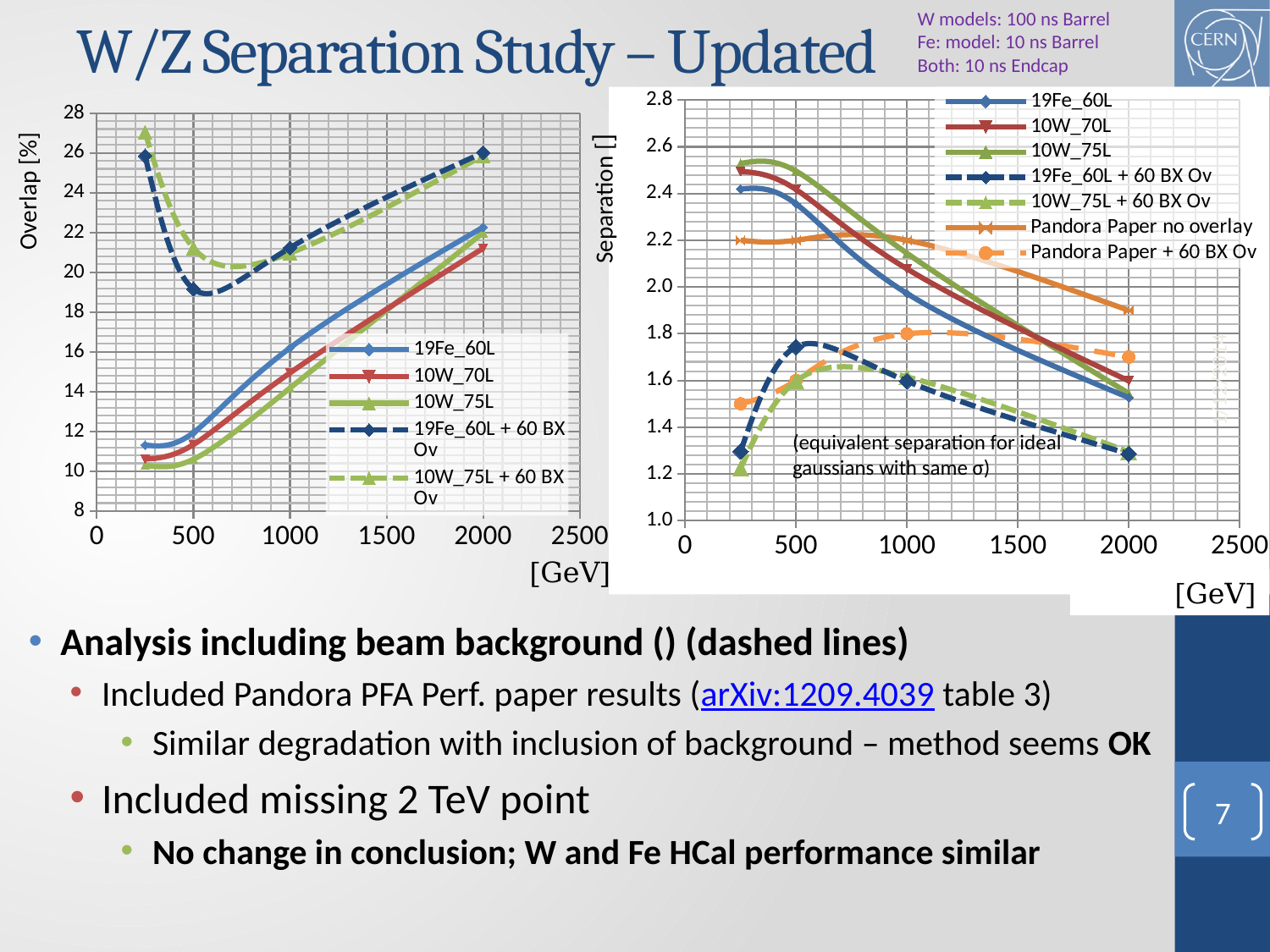
In the right chart (Separation []), which is larger at 2000 GeV: Pandora Paper no overlay or 19Fe_60L? Pandora Paper no overlay In the left chart (Overlap [%]), is the value for 19Fe_60L at 2000 GeV greater or less than 20? greater In the right chart (Separation []), do the solid-line series 19Fe_60L, 10W_70L and 10W_75L rise or fall as energy increases from 500 to 2000 GeV? fall In the right chart (Separation []), is the value for 19Fe_60L + 60 BX Ov at 2000 GeV greater or less than 1.6? less How many series does the legend of the right chart (Separation []) list? 7 What is the label of the y axis of the left chart? Overlap [%] In the left chart (Overlap [%]), is the value for 10W_75L at 250 GeV greater or less than 12? less What kind of chart is the left chart (Overlap [%])? line chart In the left chart (Overlap [%]), which is larger at 2000 GeV: 19Fe_60L or 19Fe_60L + 60 BX Ov? 19Fe_60L + 60 BX Ov How many series does the legend of the left chart (Overlap [%]) list? 5